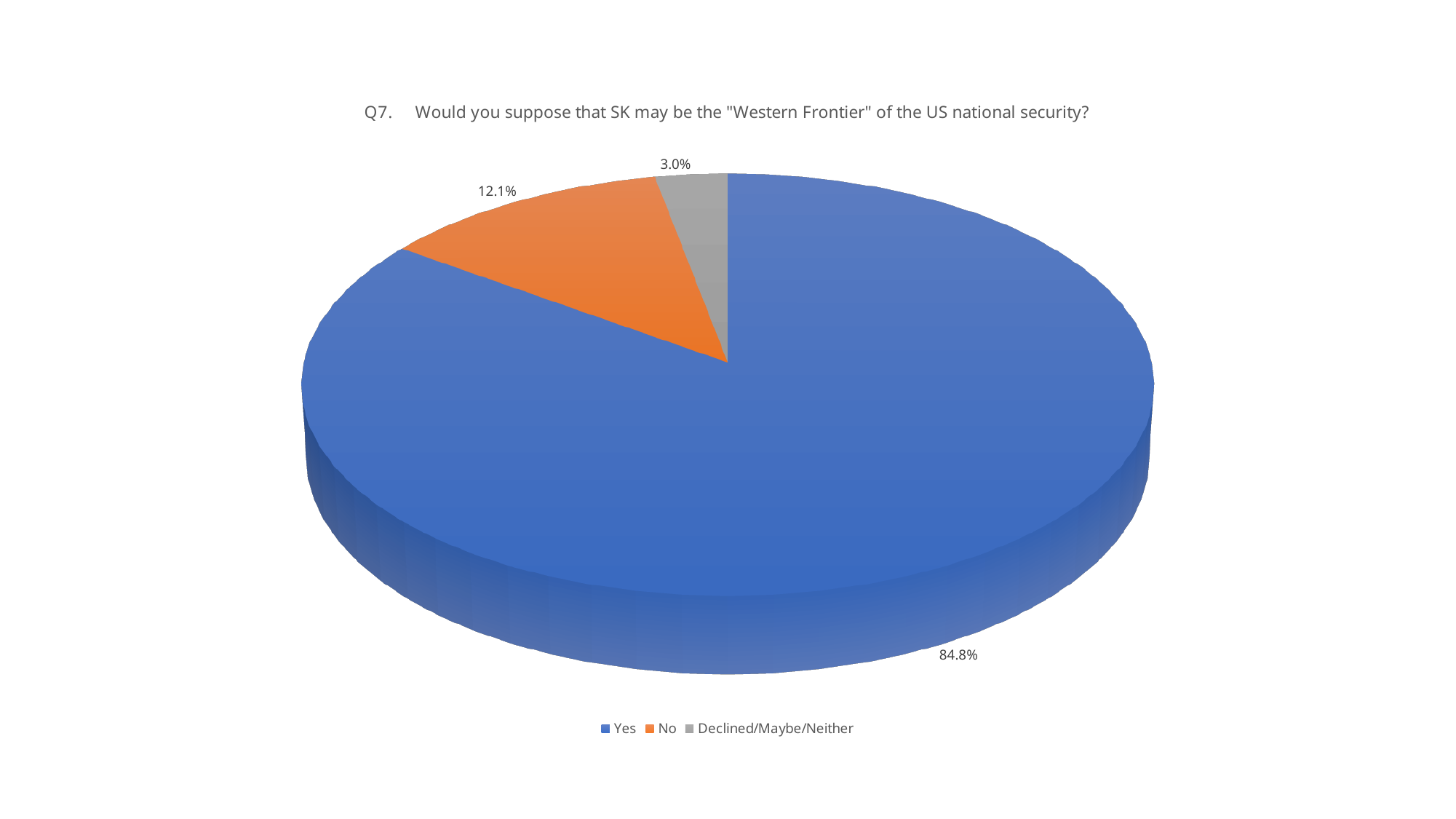
What colour is the "No" slice? Orange What percentage of respondents answered "Declined/Maybe/Neither"? 3.0% What type of chart is shown on the slide? Pie chart What percentage of respondents answered "No"? 12.1% Which response has the largest share of the pie? Yes Which is larger, the share for "No" or the share for "Declined/Maybe/Neither"? No What percentage of respondents answered "Yes"? 84.8% What is the difference in percentage points between the "No" and "Declined/Maybe/Neither" shares? 9.1 What question number is shown in the chart title? Q7 Which response has the smallest share of the pie? Declined/Maybe/Neither How many categories does the pie chart have? 3 What is the difference in percentage points between the "Yes" and "No" shares? 72.7